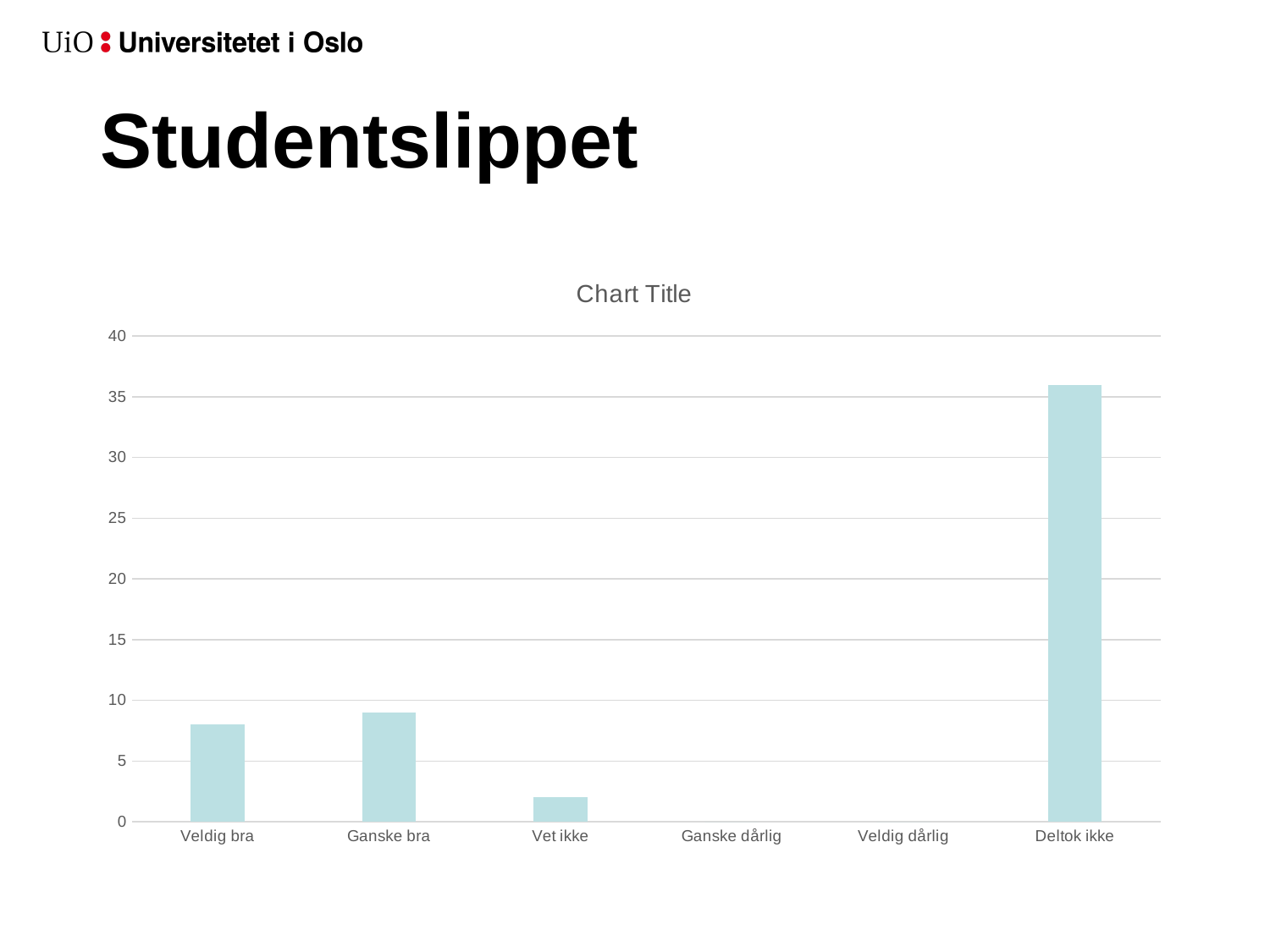
How many categories are shown on the x axis of the chart? 6 Is the value for Ganske bra greater or less than 5? greater Which is larger, the value for Veldig bra or the value for Vet ikke? Veldig bra What is the highest value shown on the y axis of the chart? 40 Is the value for Vet ikke greater or less than 5? less What is the title shown above the chart? Chart Title What type of chart is shown on the slide? bar chart Is the value for Deltok ikke greater or less than 35? greater Which category has the highest value in the chart? Deltok ikke Which is larger, the value for Deltok ikke or the value for Ganske bra? Deltok ikke